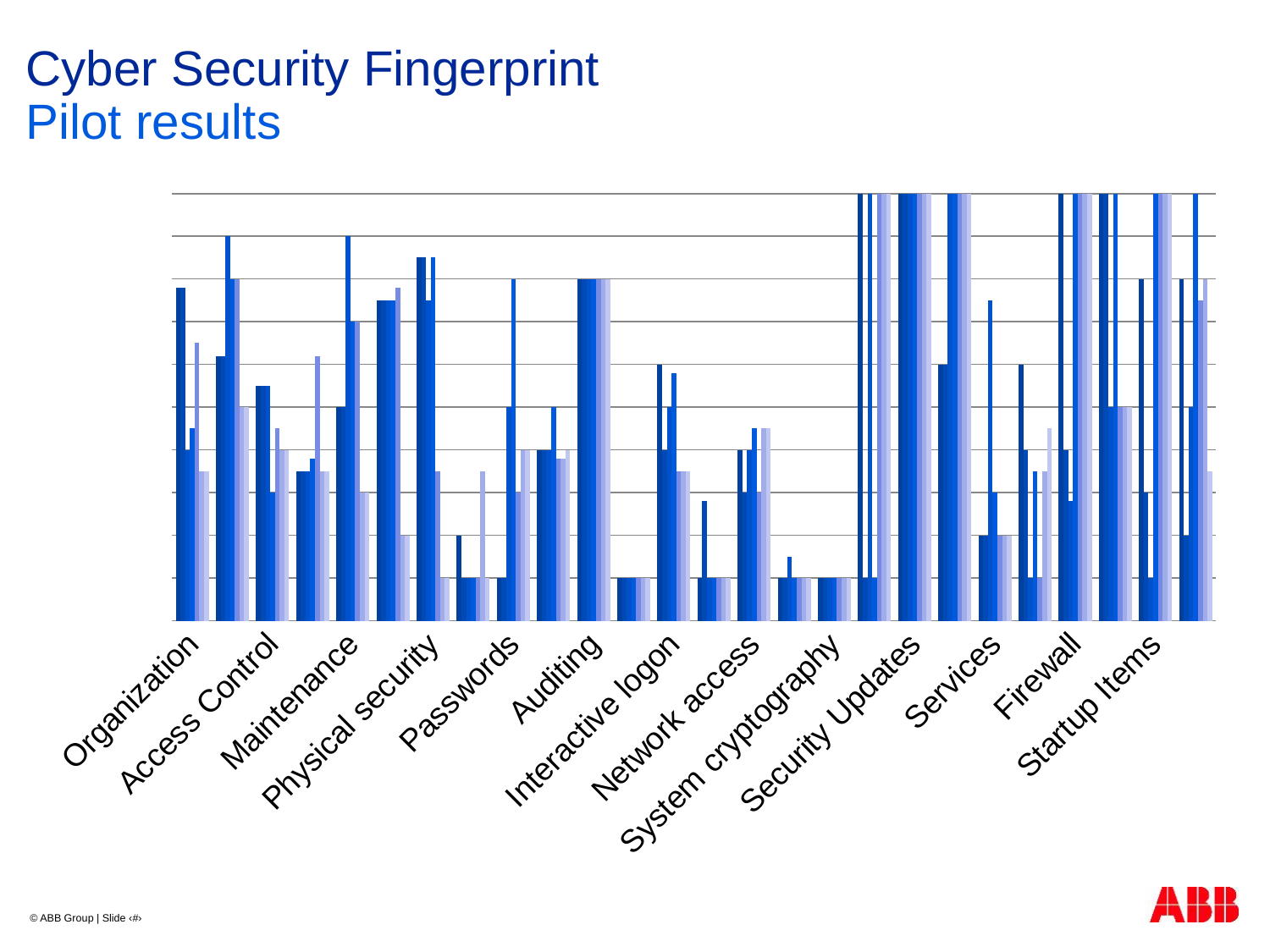
What kind of chart is shown on the slide? bar chart Which category has higher bars, Security Updates or System cryptography? Security Updates What is the last category label on the x axis of the chart? Startup Items Which category has higher bars, Auditing or System cryptography? Auditing What is the first category label on the x axis of the chart? Organization How many category labels are shown along the x axis of the chart? 13